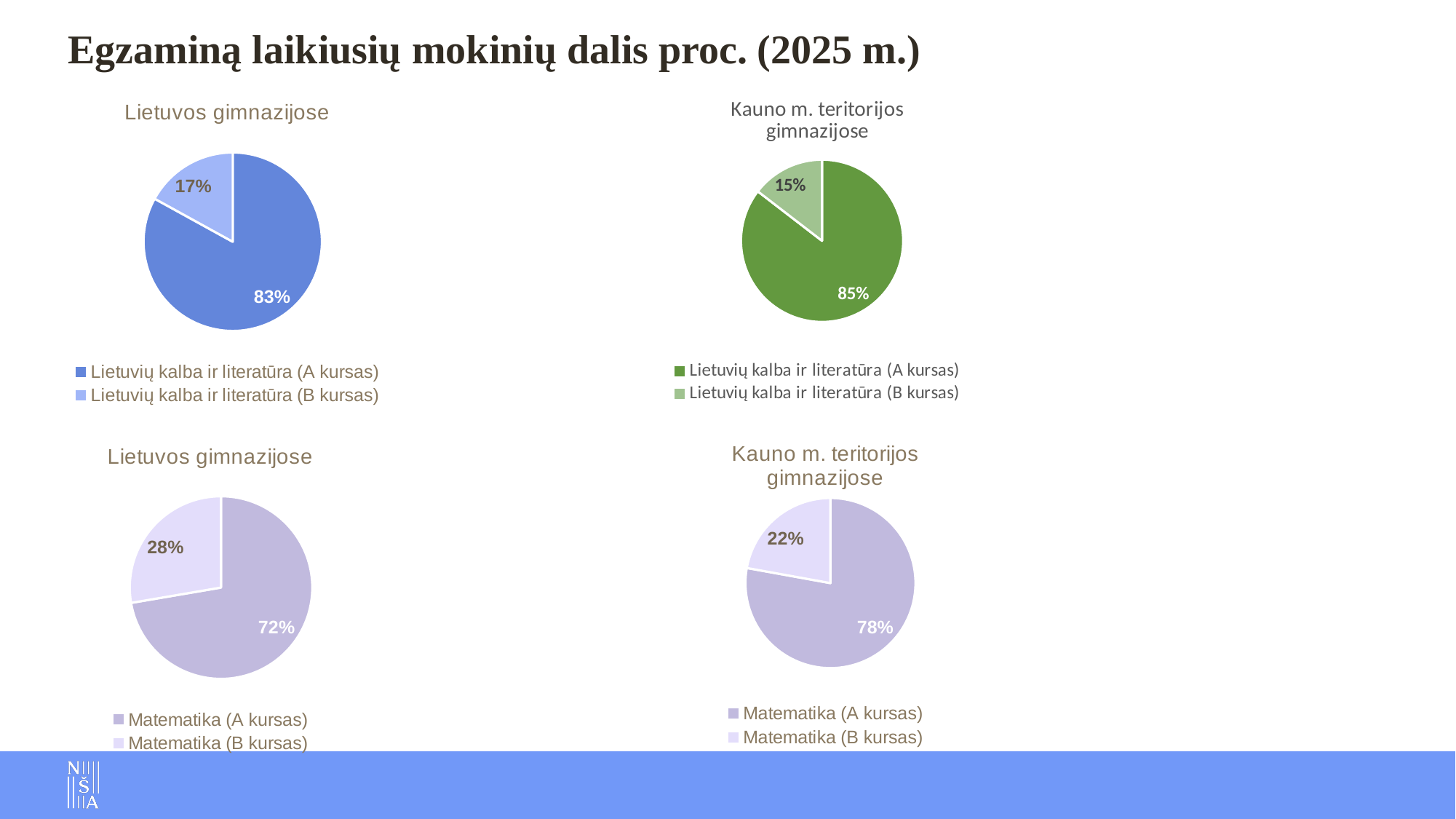
In the bottom-left pie chart (Lietuvos gimnazijose, Matematika), what share is Matematika (A kursas)? 72% In the bottom-right pie chart (Kauno m. teritorijos gimnazijose, Matematika), what share is Matematika (B kursas)? 22% In the bottom-left pie chart (Lietuvos gimnazijose, Matematika), which slice is the largest? Matematika (A kursas) In the bottom-right pie chart (Kauno m. teritorijos gimnazijose, Matematika), what is the difference between the Matematika (A kursas) and Matematika (B kursas) shares? 56% Which is larger: the Matematika (B kursas) share in the bottom-left chart (Lietuvos gimnazijose) or in the bottom-right chart (Kauno m. teritorijos gimnazijose)? Lietuvos gimnazijose (28%) How many slices does the bottom-right pie chart (Kauno m. teritorijos gimnazijose, Matematika) have? 2 In the top-right pie chart (Kauno m. teritorijos gimnazijose, Lietuvių kalba ir literatūra), what share is Lietuvių kalba ir literatūra (B kursas)? 15% What type of chart is the top-left chart (Lietuvos gimnazijose, Lietuvių kalba ir literatūra)? Pie chart In the top-right pie chart (Kauno m. teritorijos gimnazijose, Lietuvių kalba ir literatūra), which slice is the smallest? Lietuvių kalba ir literatūra (B kursas)